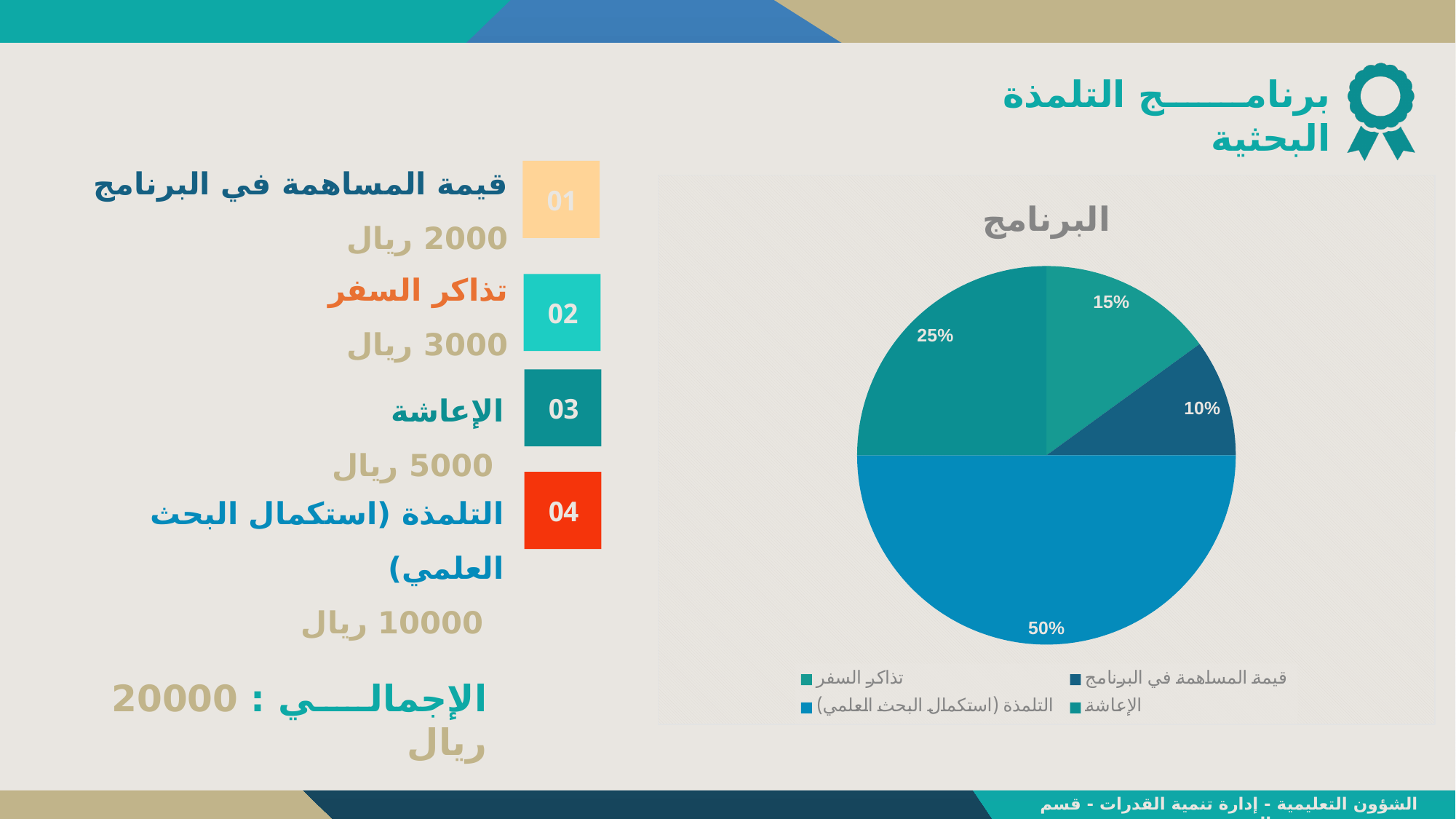
What share of the pie does الإعاشة represent? 25% How many entries does the chart legend list? 4 Which is larger, the slice for الإعاشة or the slice for قيمة المساهمة في البرنامج? الإعاشة What share of the pie does التلمذة (استكمال البحث العلمي) represent? 50% Which category has the smallest slice of the pie? قيمة المساهمة في البرنامج Which category has the largest slice of the pie? التلمذة (استكمال البحث العلمي) How many slices does the pie chart have? 4 What is the difference in percentage points between the الإعاشة slice and the تذاكر السفر slice? 10% What is the title of the chart? البرنامج What share of the pie does تذاكر السفر represent? 15% What type of chart is shown on the slide? pie chart